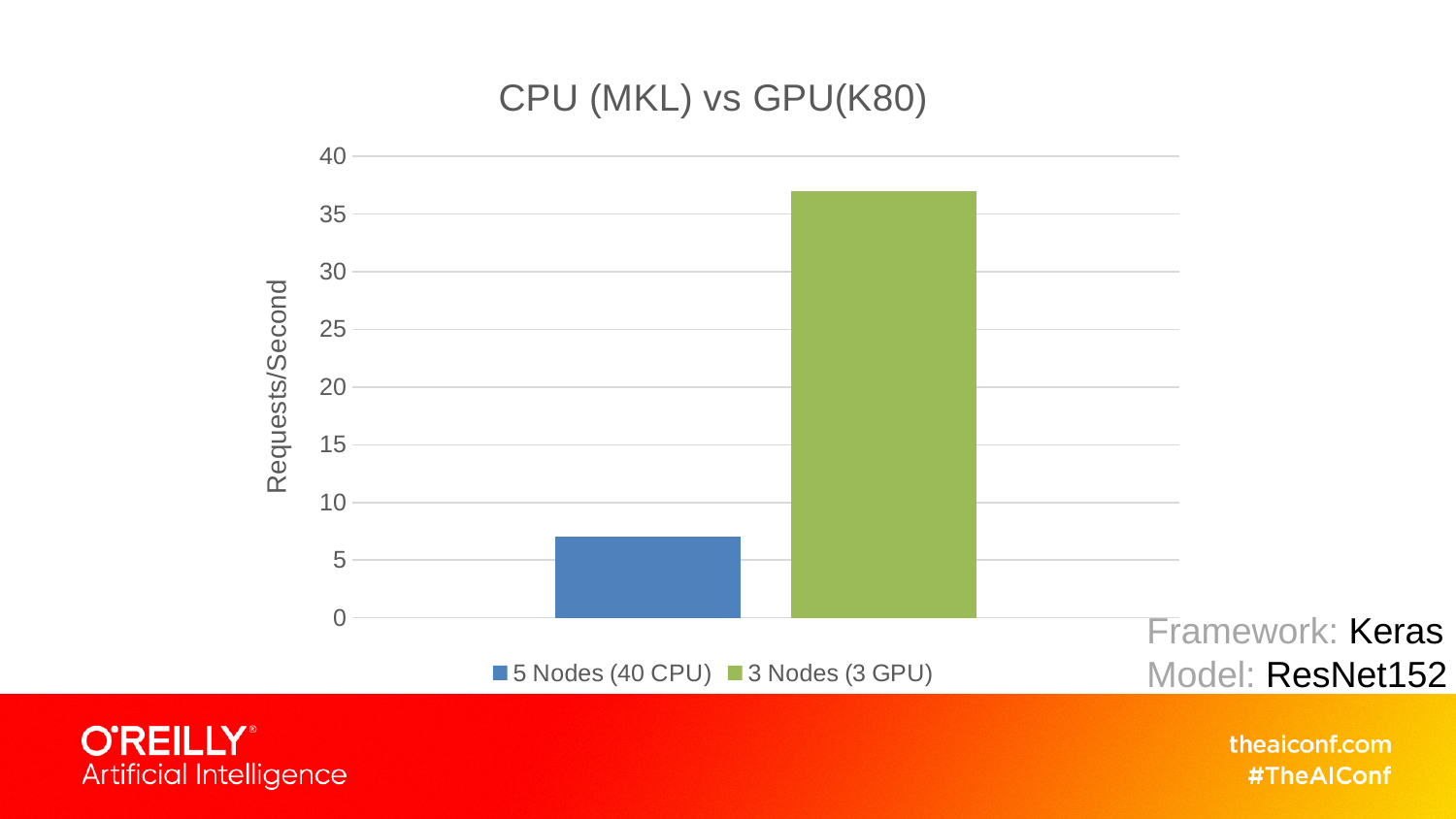
How many bars are plotted in the chart? 2 Which series has the lowest value in the chart? 5 Nodes (40 CPU) What is the label on the vertical axis of the chart? Requests/Second What type of chart is shown on the slide? bar chart Is the value for 3 Nodes (3 GPU) greater or less than 35? greater Is the value for 5 Nodes (40 CPU) greater or less than 10? less Which is larger, the value for 5 Nodes (40 CPU) or the value for 3 Nodes (3 GPU)? 3 Nodes (3 GPU) How many series does the chart's legend list? 2 Is the value for 3 Nodes (3 GPU) greater or less than 40? less What is the title of the chart? CPU (MKL) vs GPU(K80) Which series has the highest value in the chart? 3 Nodes (3 GPU)